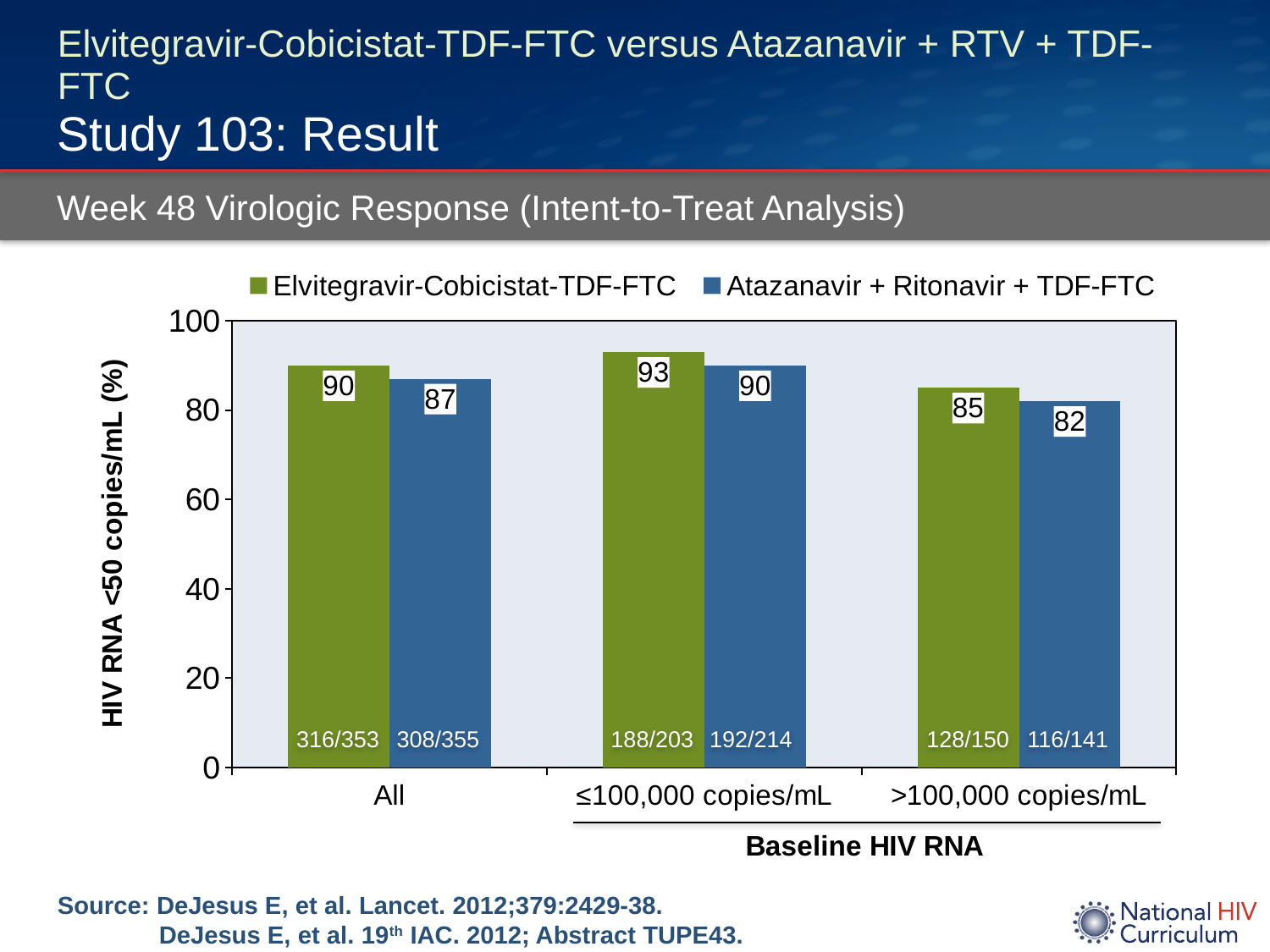
What is the value for Elvitegravir-Cobicistat-TDF-FTC in the All category? 90 Which category has the lowest value for Atazanavir + Ritonavir + TDF-FTC? >100,000 copies/mL What is the difference between the two series in the >100,000 copies/mL category? 3 What colour represents Atazanavir + Ritonavir + TDF-FTC in the chart? blue What is the y-axis label of the chart? HIV RNA <50 copies/mL (%) What is the value for Atazanavir + Ritonavir + TDF-FTC in the >100,000 copies/mL category? 82 Which category has the highest value for Elvitegravir-Cobicistat-TDF-FTC? ≤100,000 copies/mL What kind of chart is shown? bar chart How many series does the legend list? 2 What is the value for Atazanavir + Ritonavir + TDF-FTC in the ≤100,000 copies/mL category? 90 How many categories are shown on the x axis? 3 In the All category, which series has the larger value? Elvitegravir-Cobicistat-TDF-FTC